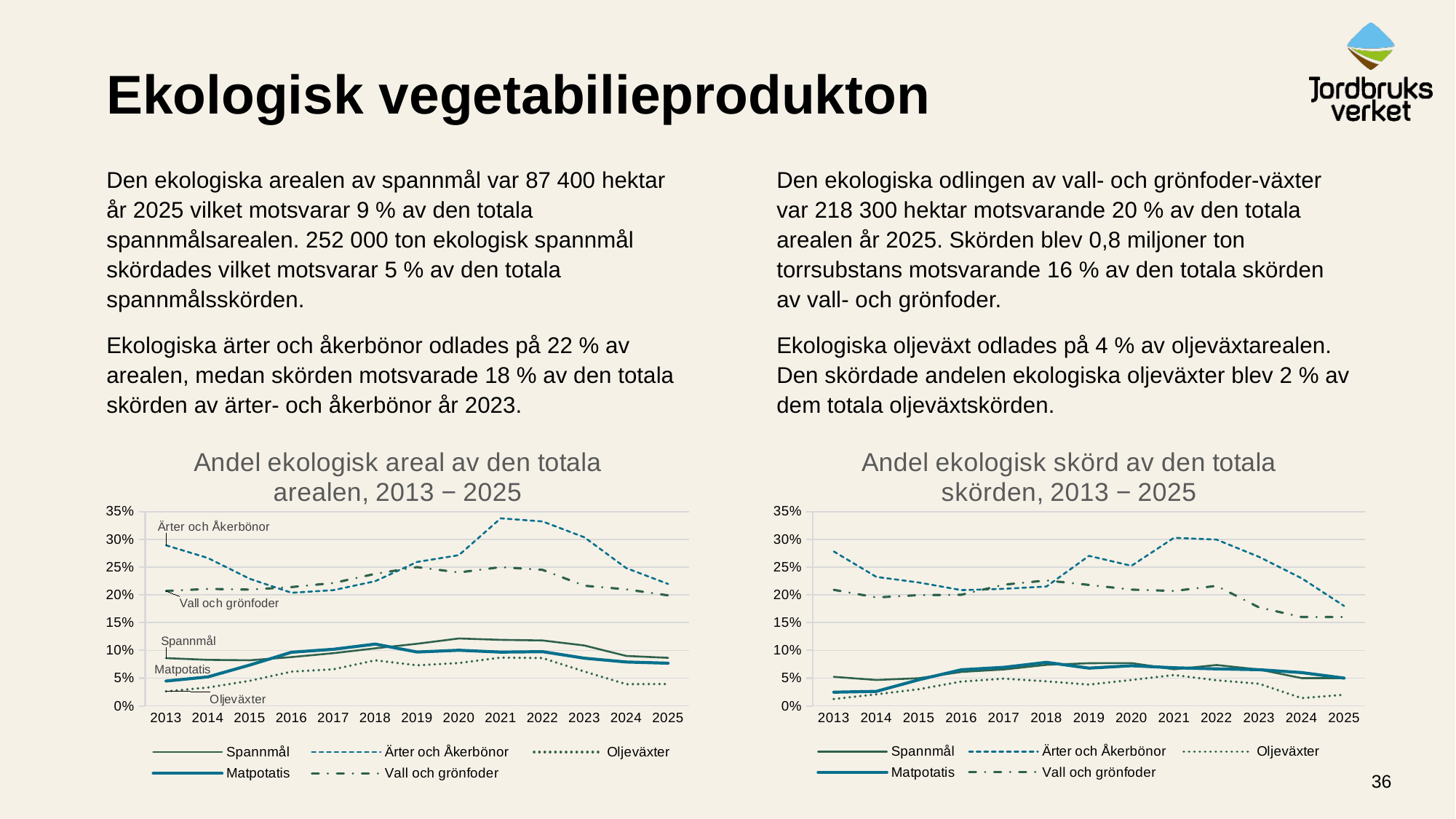
In the left chart, 'Andel ekologisk areal av den totala arealen', is the value for Oljeväxter in 2025 greater or less than 5%? less In the right chart, 'Andel ekologisk skörd av den totala skörden', which is larger in 2013: Ärter och Åkerbönor or Oljeväxter? Ärter och Åkerbönor In the left chart, 'Andel ekologisk areal av den totala arealen', which series has the lowest value in 2013? Oljeväxter How many series does the legend of the right chart, 'Andel ekologisk skörd av den totala skörden, 2013 − 2025', list? 5 In the right chart, 'Andel ekologisk skörd av den totala skörden', which series has the highest value in 2013? Ärter och Åkerbönor In the right chart, 'Andel ekologisk skörd av den totala skörden', does the Ärter och Åkerbönor series rise or fall from 2021 to 2025? fall How many years are shown on the x axis of the left chart, 'Andel ekologisk areal av den totala arealen, 2013 − 2025'? 13 In the right chart, 'Andel ekologisk skörd av den totala skörden', is the value for Vall och grönfoder in 2025 greater or less than 20%? less In the left chart, 'Andel ekologisk areal av den totala arealen', is the value for Ärter och Åkerbönor in 2021 greater or less than 30%? greater What is the title of the right chart on the slide? Andel ekologisk skörd av den totala skörden, 2013 − 2025 In the left chart, 'Andel ekologisk areal av den totala arealen', which series has the highest value in 2021? Ärter och Åkerbönor What kind of chart is the left chart, 'Andel ekologisk areal av den totala arealen, 2013 − 2025'? Line chart